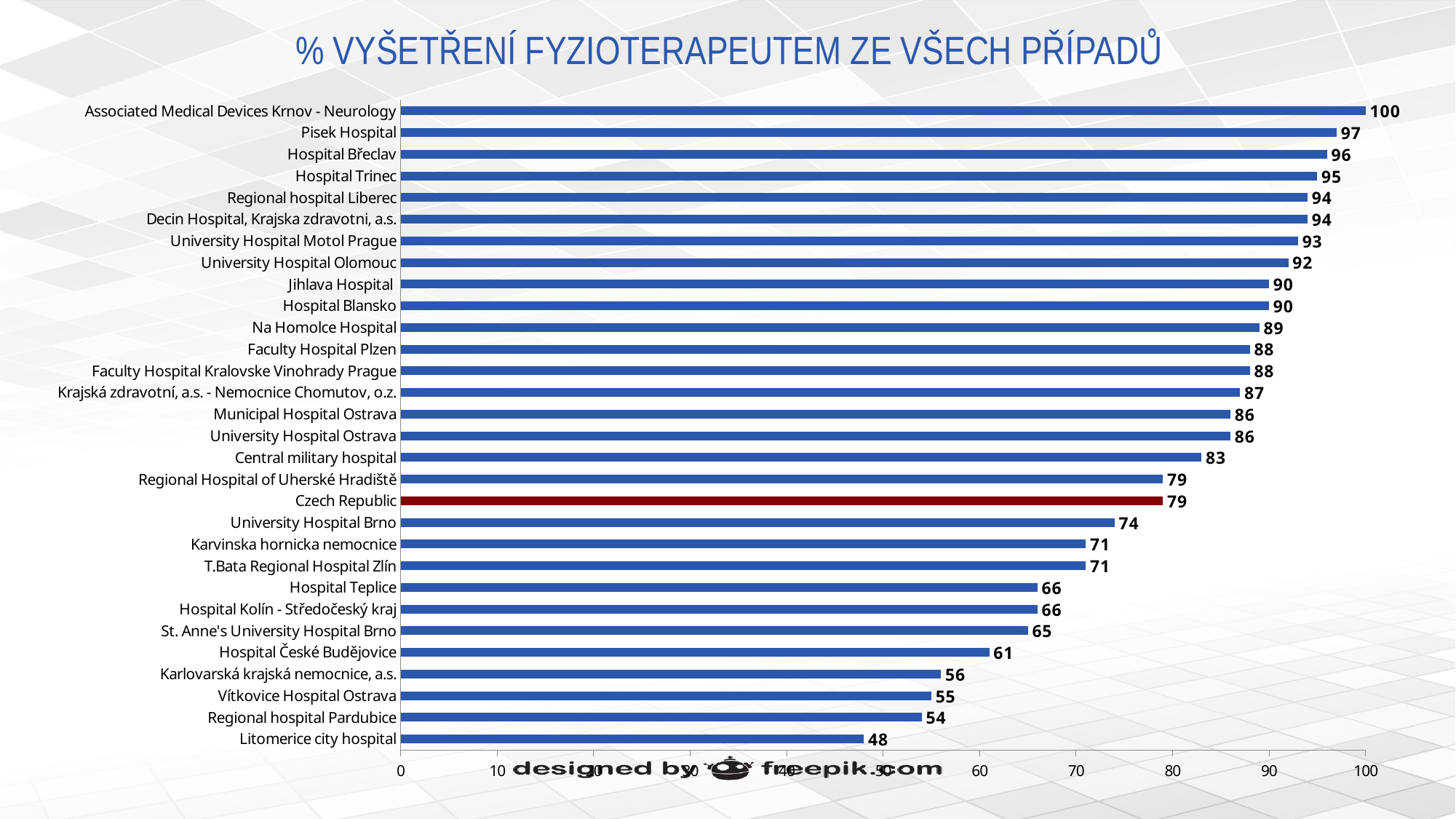
Which bar is shown in a different colour (dark red) from the others? Czech Republic Which category has the highest value? Associated Medical Devices Krnov - Neurology Which category has the lowest value? Litomerice city hospital What is the value for Hospital Teplice? 66 What is the value for Czech Republic? 79 How many categories are shown in the chart? 30 What kind of chart is shown on the slide? bar chart What is the value for University Hospital Motol Prague? 93 What is the difference between the values for University Hospital Brno and Czech Republic? 5 Is the value for Regional hospital Pardubice greater or less than 60? less Which is larger, the value for Central military hospital or the value for Hospital České Budějovice? Central military hospital What is the difference between the values for Pisek Hospital and Litomerice city hospital? 49